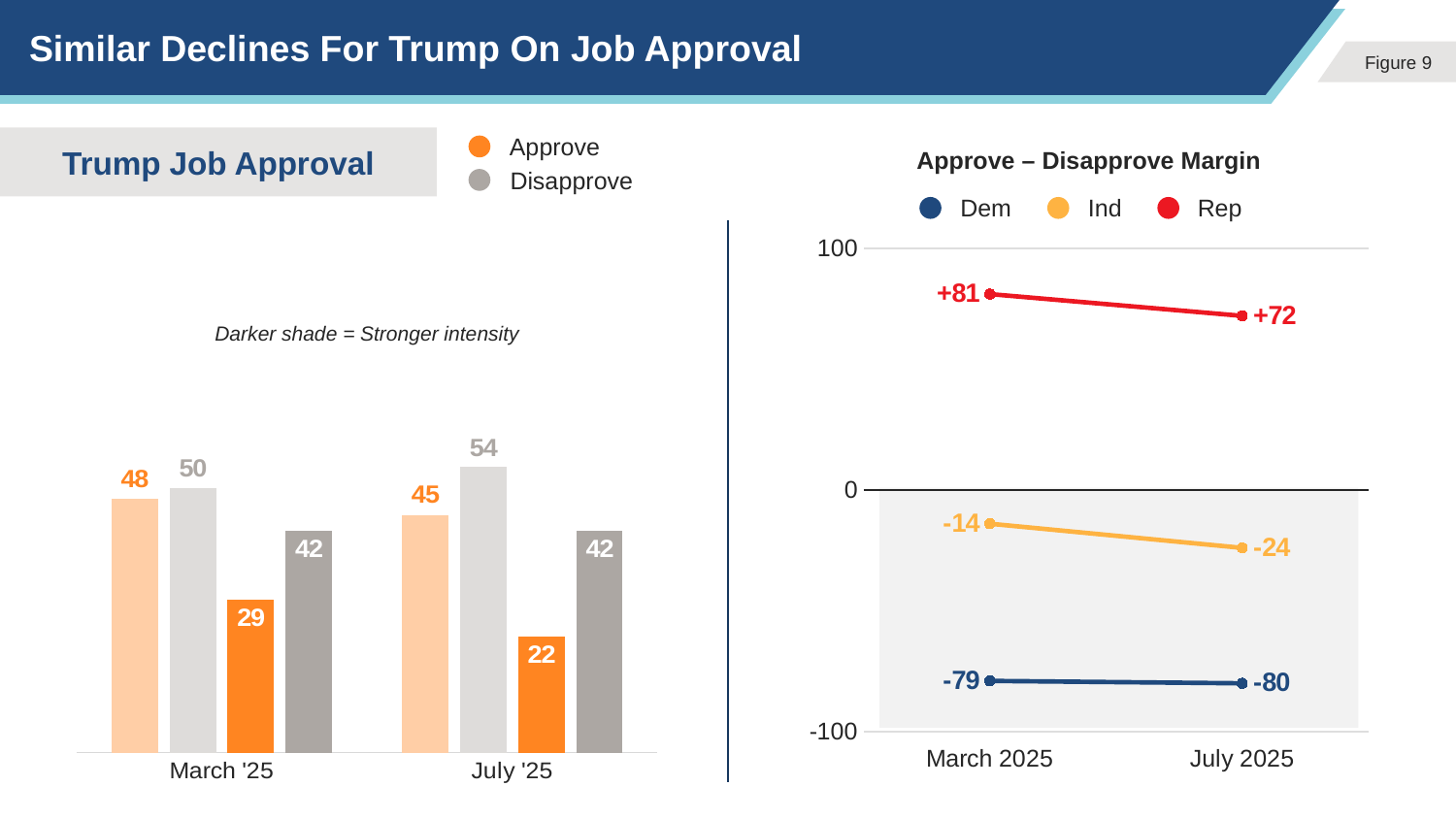
In the Approve – Disapprove Margin chart, what is the difference between the Rep margin in March 2025 and July 2025? 9 In the Approve – Disapprove Margin chart, what is the Ind margin in March 2025? -14 In the Trump Job Approval chart, by how much did the Approve value fall from March '25 to July '25? 3 What kind of chart is the Trump Job Approval chart? Bar chart In the Trump Job Approval chart, what is the Disapprove value for July '25? 54 In the Approve – Disapprove Margin chart, which group has the lowest margin in July 2025? Dem In the Approve – Disapprove Margin chart, how many series does the legend list? 3 In the Trump Job Approval chart, which is larger for July '25, Approve or Disapprove? Disapprove In the Trump Job Approval chart, what is the Approve value for March '25? 48 In the Approve – Disapprove Margin chart, what is the Rep margin in July 2025? +72 In the Approve – Disapprove Margin chart, does the Ind margin rise or fall from March 2025 to July 2025? Fall In the Trump Job Approval chart, what is the strong-intensity (darker shade) Approve value for July '25? 22